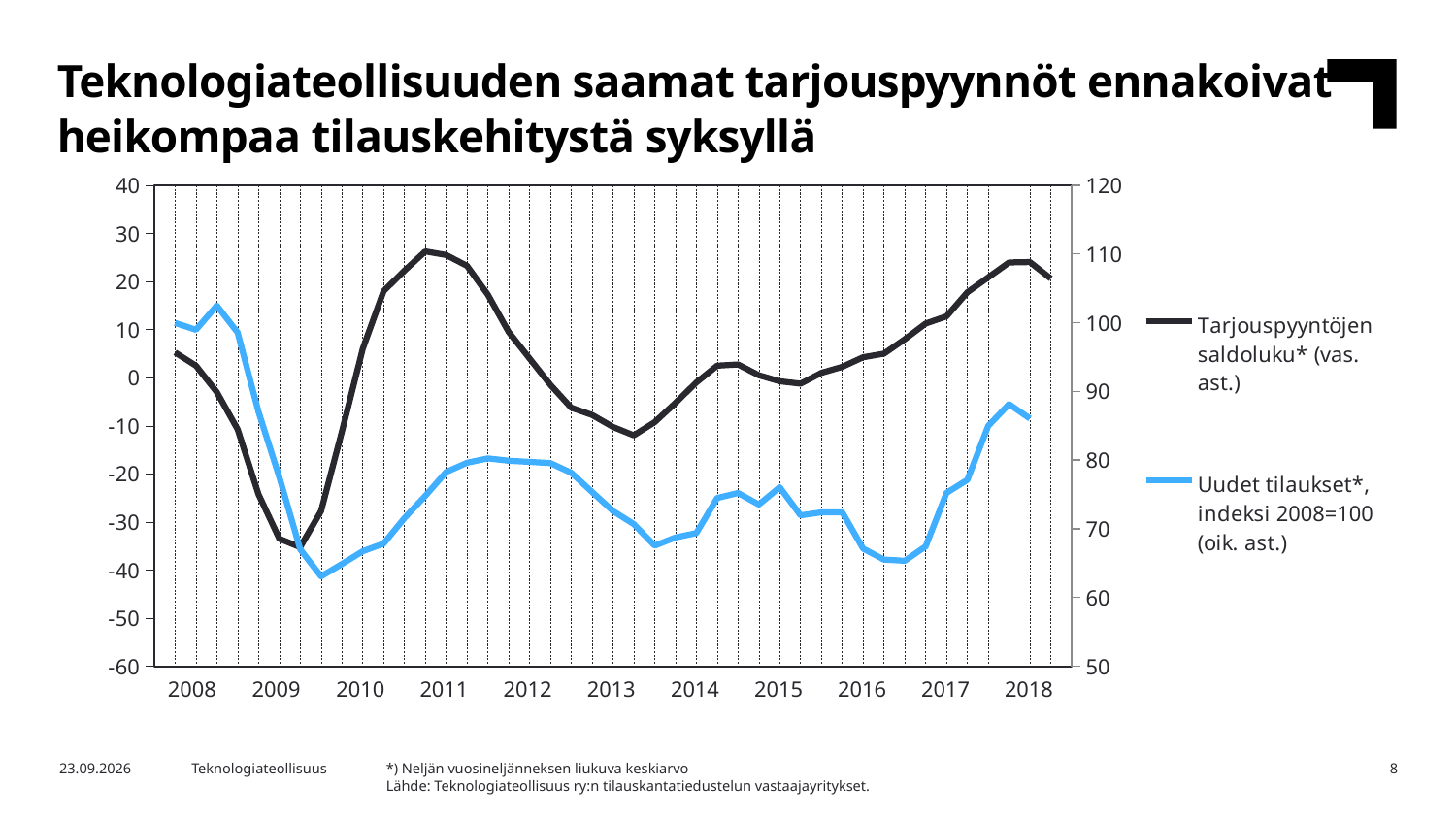
What kind of chart is shown on the slide? line chart How many series does the legend list? 2 In which year does Tarjouspyyntöjen saldoluku reach its lowest point? 2009 Is the lowest value of Tarjouspyyntöjen saldoluku around 2009 greater or less than -30? less Is the peak value of Tarjouspyyntöjen saldoluku around 2011 greater or less than 20? greater Is the lowest value of Uudet tilaukset around 2009 greater or less than 70? less How many years are labelled on the x axis? 11 In which year does Uudet tilaukset reach its lowest point? 2009 What are the two series named in the legend? Tarjouspyyntöjen saldoluku* (vas. ast.) and Uudet tilaukset*, indeksi 2008=100 (oik. ast.) Does Tarjouspyyntöjen saldoluku rise or fall from 2016 to 2018? rise Is Tarjouspyyntöjen saldoluku higher in 2011 or in 2013? 2011